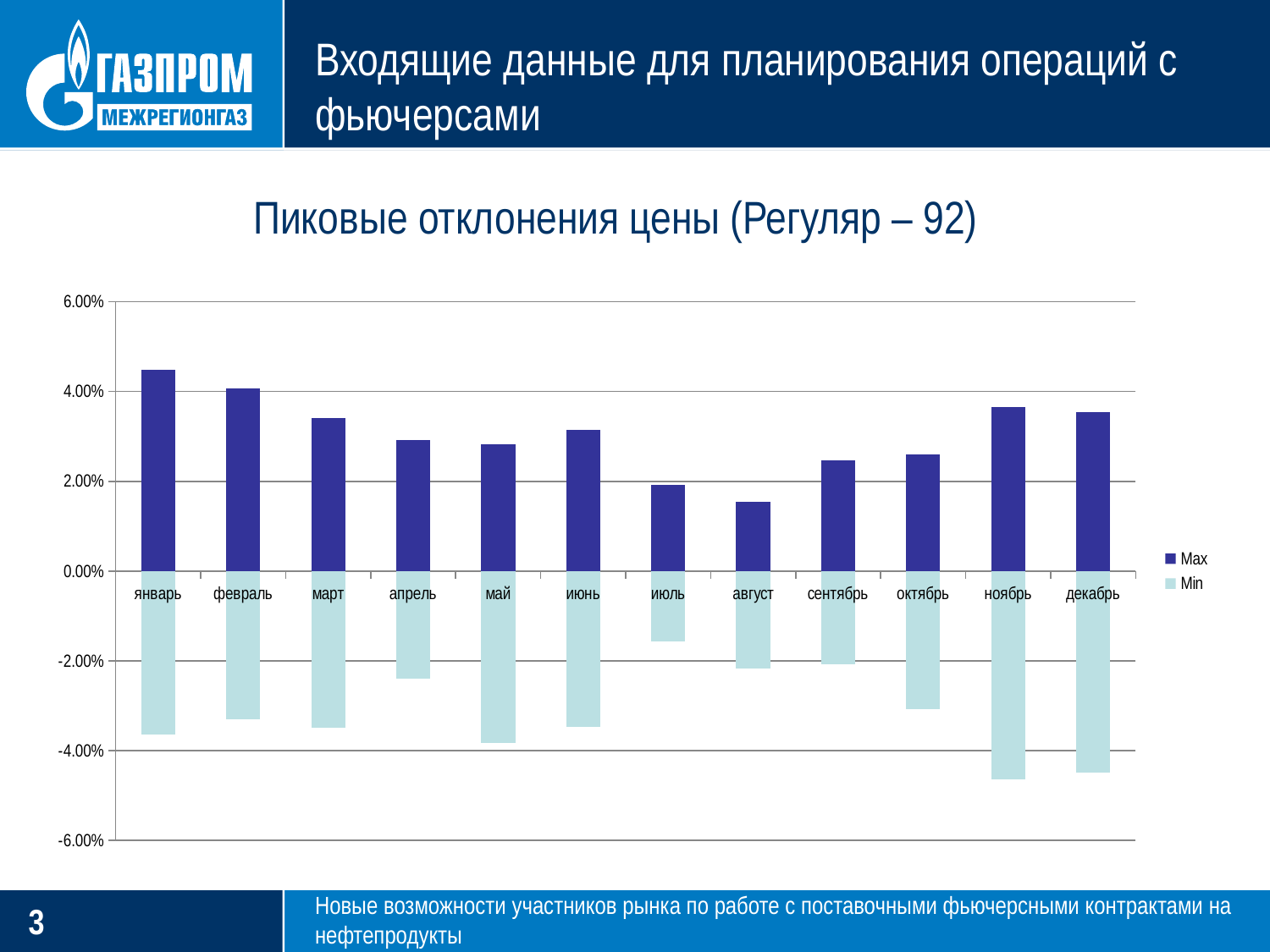
Which month has the highest Max value? январь Is the Max value for январь greater or less than 4.00%? greater What is the title of the chart? Пиковые отклонения цены (Регуляр – 92) Is the Max value for август greater or less than 2.00%? less Is the Min value for июль greater or less than -2.00%? greater How many months are shown on the x axis of the chart? 12 How many series does the chart legend list? 2 What are the two series named in the chart legend? Max and Min Which is larger, the Max value for февраль or the Max value for июль? февраль What kind of chart is shown on the slide? bar chart Which month has the lowest Max value? август